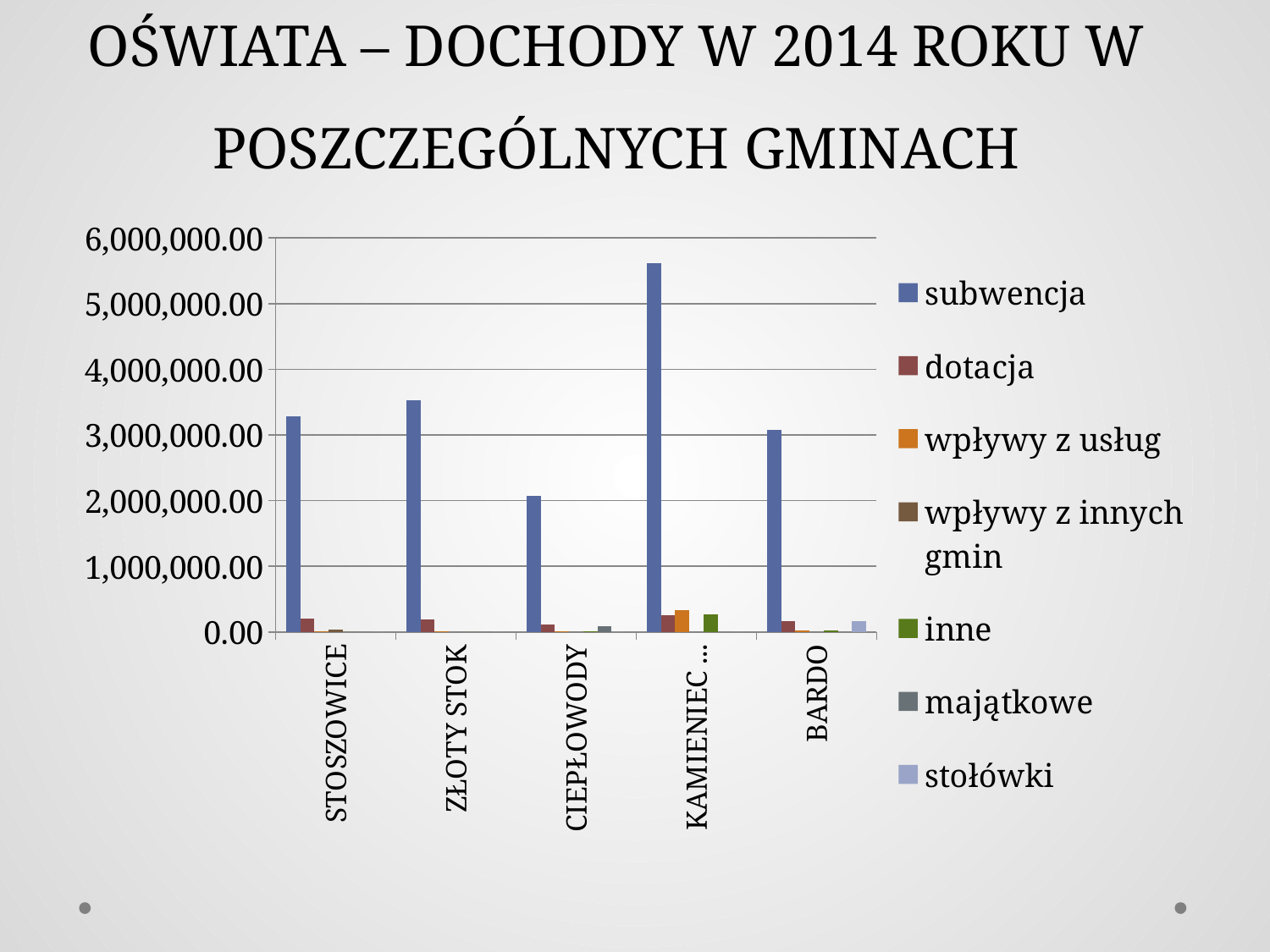
How many gminas (categories) are shown on the x axis? 5 Is the subwencja value for CIEPŁOWODY greater or less than 3,000,000.00? less Which is larger, the subwencja value for ZŁOTY STOK or for CIEPŁOWODY? ZŁOTY STOK Which gmina has the highest subwencja value? KAMIENIEC ... Which gmina has the lowest subwencja value? CIEPŁOWODY Is the subwencja value for STOSZOWICE greater or less than 3,000,000.00? greater What kind of chart is shown on the slide? bar chart Which series is listed first in the legend? subwencja Is the subwencja value for KAMIENIEC greater or less than 5,000,000.00? greater What is the title of the slide? OŚWIATA – DOCHODY W 2014 ROKU W POSZCZEGÓLNYCH GMINACH How many series does the legend list? 7 Which is larger, the subwencja value for KAMIENIEC or for BARDO? KAMIENIEC